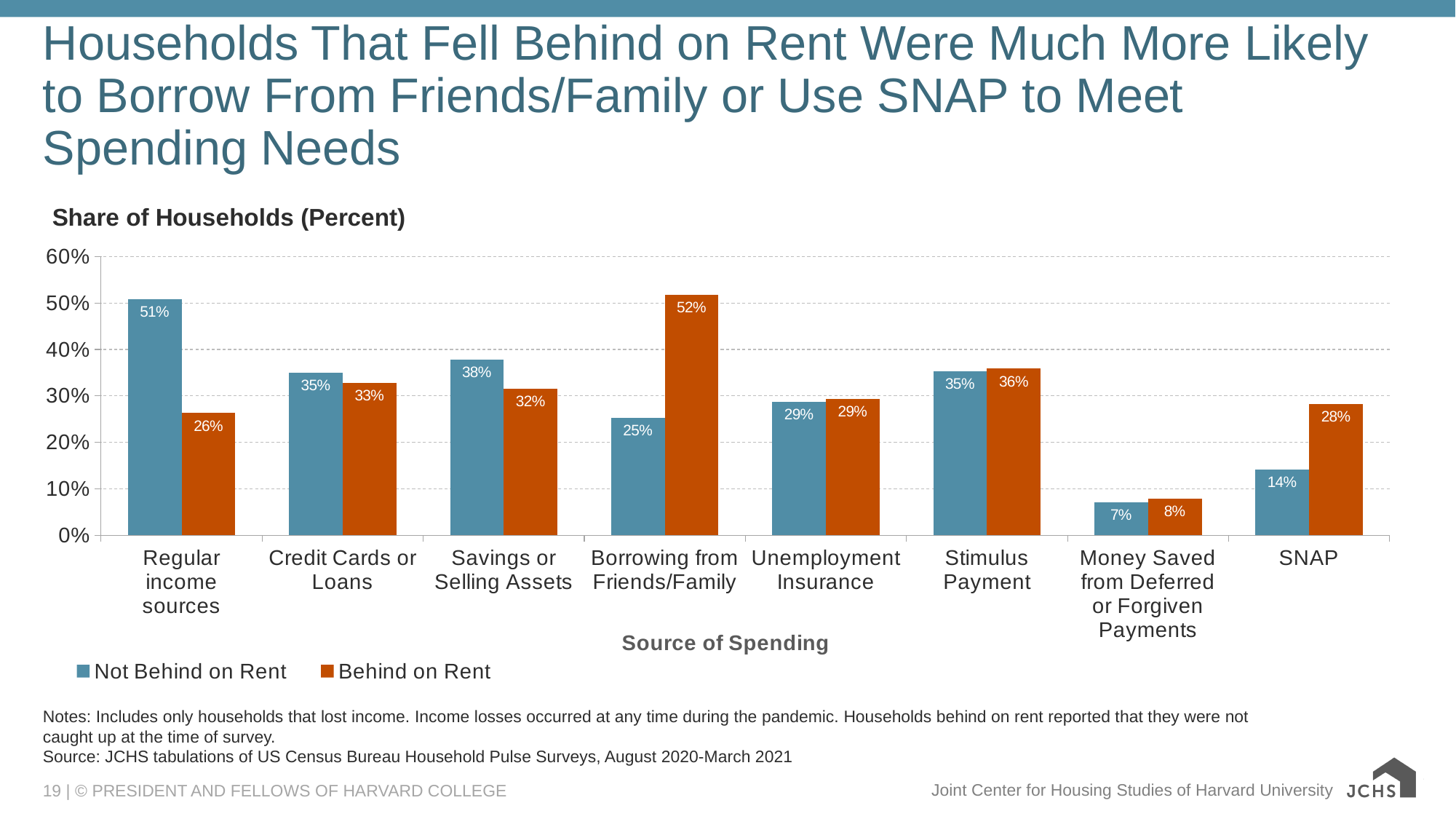
What is the value for Behind on Rent households for SNAP? 28% Which source of spending has the lowest value for Behind on Rent households? Money Saved from Deferred or Forgiven Payments What kind of chart is shown on the slide? Bar chart What is the value for Behind on Rent households for Borrowing from Friends/Family? 52% What is the value for Not Behind on Rent households for Regular income sources? 51% Which source of spending has the highest value for Not Behind on Rent households? Regular income sources For SNAP, which group has the larger value: Not Behind on Rent or Behind on Rent? Behind on Rent How many sources of spending are shown on the x axis? 8 Is the value for Not Behind on Rent households for Savings or Selling Assets greater or less than 30%? greater What is the difference between Behind on Rent and Not Behind on Rent households for Borrowing from Friends/Family? 27% How many series does the legend list? 2 What is the label of the x axis? Source of Spending